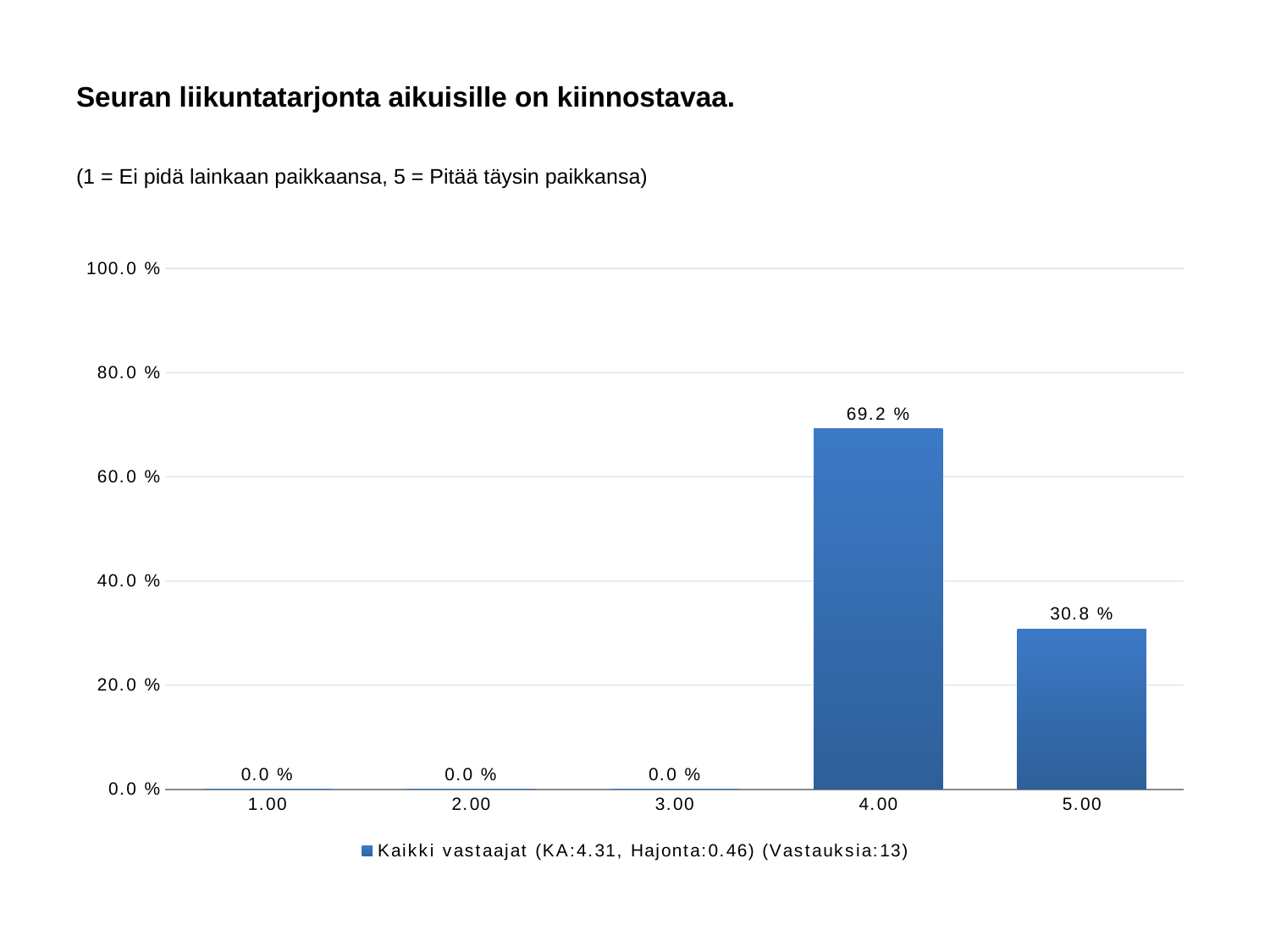
How many series does the legend list? 1 Which category has the highest value? 4.00 Is the value for 5.00 greater or less than 40.0 %? less What kind of chart is shown? bar chart What is the value for category 4.00? 69.2 % What is the value for category 1.00? 0.0 % What is the title of the slide? Seuran liikuntatarjonta aikuisille on kiinnostavaa. Which is larger, the value for 4.00 or the value for 5.00? 4.00 What is the value for category 5.00? 30.8 % What is the difference between the values for 4.00 and 5.00? 38.4 % How many categories are shown on the x axis? 5 Is the value for 4.00 greater or less than 60.0 %? greater